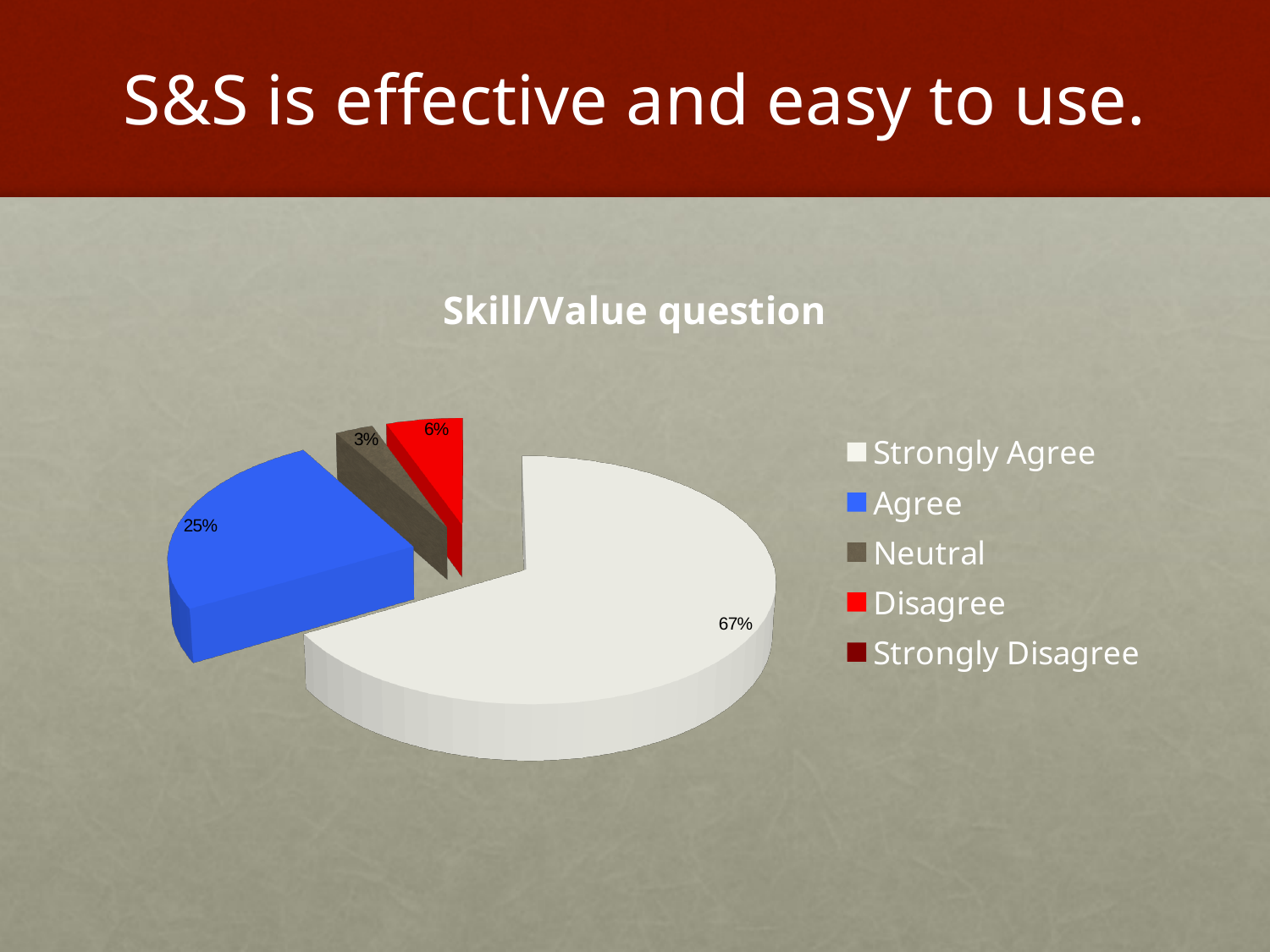
What is the difference in percentage points between the Strongly Agree slice and the Agree slice? 42% Which response category has the largest slice of the pie? Strongly Agree How many response categories does the legend list? 5 Which slice is larger, Disagree or Neutral? Disagree What kind of chart is shown on the slide? Pie chart What percentage of the pie is labelled for Neutral? 3% What percentage of the pie is labelled for Agree? 25% What is the title of the chart? Skill/Value question What colour is the Agree slice in the pie chart? Blue What is the combined percentage of the Strongly Agree and Agree slices? 92% What percentage of the pie is labelled for Disagree? 6% What percentage of the pie is labelled for Strongly Agree? 67%